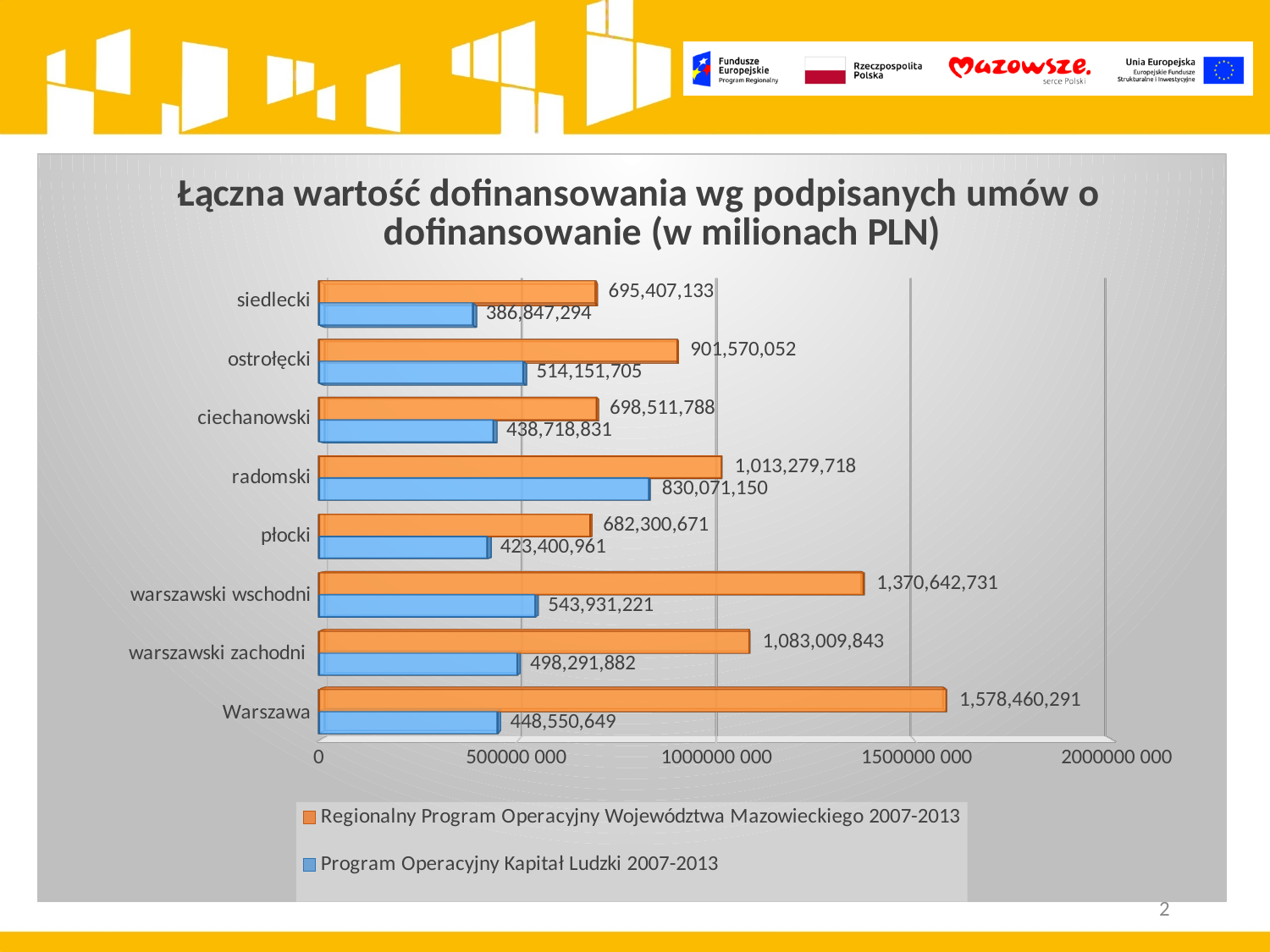
Which category has the highest value in the Regionalny Program Operacyjny Województwa Mazowieckiego 2007-2013 series? Warszawa What is the difference between the two series values for Warszawa? 1,129,909,642 What is the value for ostrołęcki in the Regionalny Program Operacyjny Województwa Mazowieckiego 2007-2013 series? 901,570,052 How many categories are shown on the chart? 8 Which category has the highest value in the Program Operacyjny Kapitał Ludzki 2007-2013 series? radomski Which category has the lowest value in the Program Operacyjny Kapitał Ludzki 2007-2013 series? siedlecki Is the Regionalny Program Operacyjny value for warszawski wschodni greater or less than 1000000 000? greater Which is larger: the Regionalny Program Operacyjny value for warszawski wschodni or for warszawski zachodni? warszawski wschodni What is the difference between the two series values for radomski? 183,208,568 How many series does the legend list? 2 What is the value for Warszawa in the Regionalny Program Operacyjny Województwa Mazowieckiego 2007-2013 series? 1,578,460,291 What is the value for radomski in the Program Operacyjny Kapitał Ludzki 2007-2013 series? 830,071,150